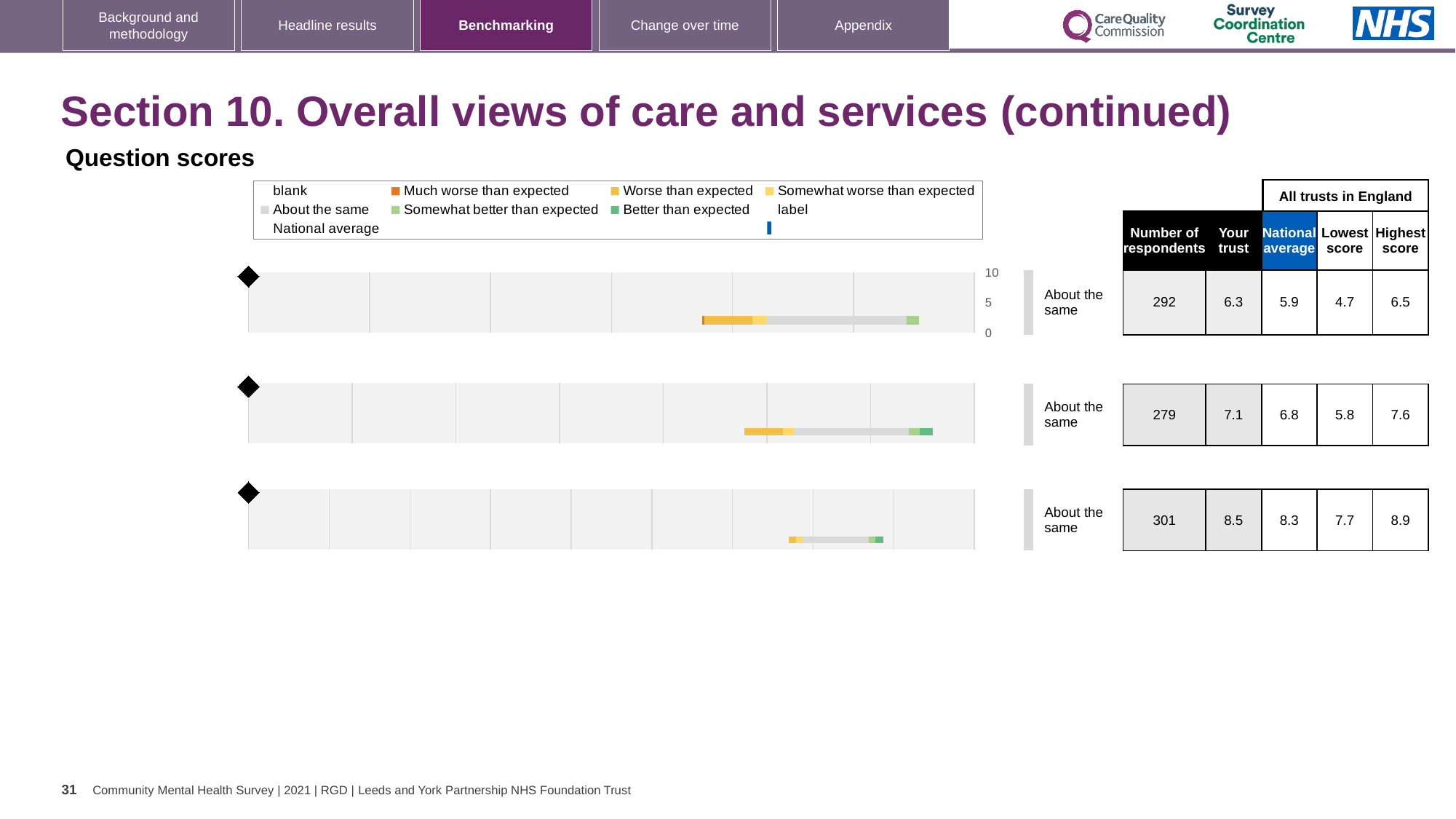
For the middle chart's table row, what is the difference between the highest score and the lowest score? 1.8 For the bottom chart's table row, which is larger: the 'Your trust' score or the national average? Your trust In the table next to the top chart, what is the 'Your trust' score? 6.3 How many question score charts are shown on the slide? 3 What is the highest tick value shown on the vertical axis of the top chart? 10 What benchmark category is shown next to the top chart? About the same In the table next to the bottom chart, what is the number of respondents? 301 In the table next to the middle chart, what is the national average? 6.8 How many entries does the legend above the charts list? 9 What kind of chart is used for the three question score charts on the slide? bar chart Which of the three table rows has the lowest number of respondents? the middle row (279) Which of the three table rows has the highest 'Your trust' score? the bottom row (8.5)